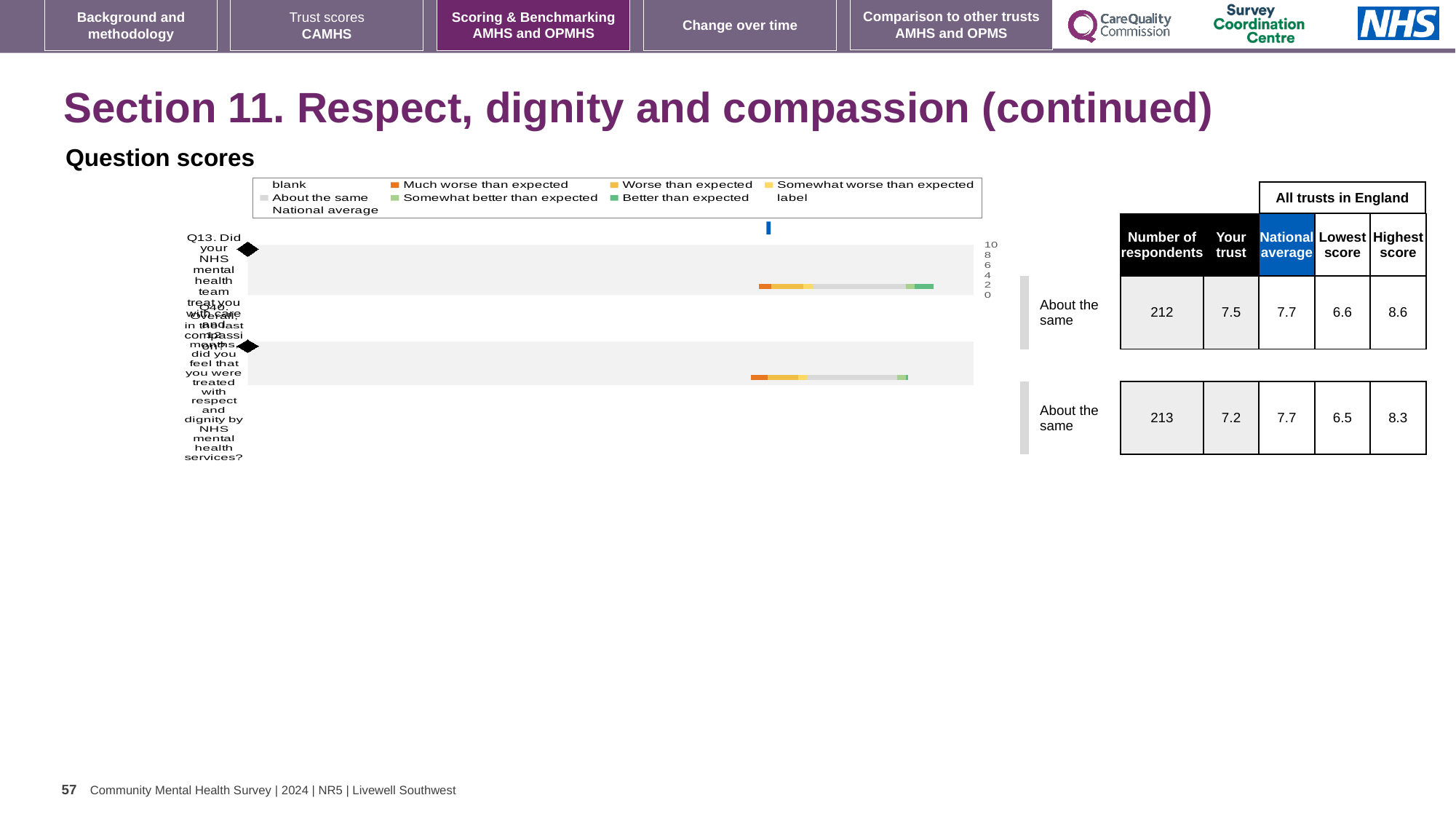
What is the difference between the highest and lowest scores for Q13? 2.0 What is the lowest score among all trusts in England for Q10? 6.5 How many questions (categories) are plotted in the question scores chart? 2 What benchmark category is shown for Q10? About the same Which question has the higher 'Your trust' score, Q13 or Q10? Q13 What is the highest score among all trusts in England for Q13? 8.6 How many respondents answered Q10? 213 What is the maximum value shown on the chart's score axis? 10 What is the national average score for Q13? 7.7 What kind of chart is used to show the question scores on this slide? bar chart